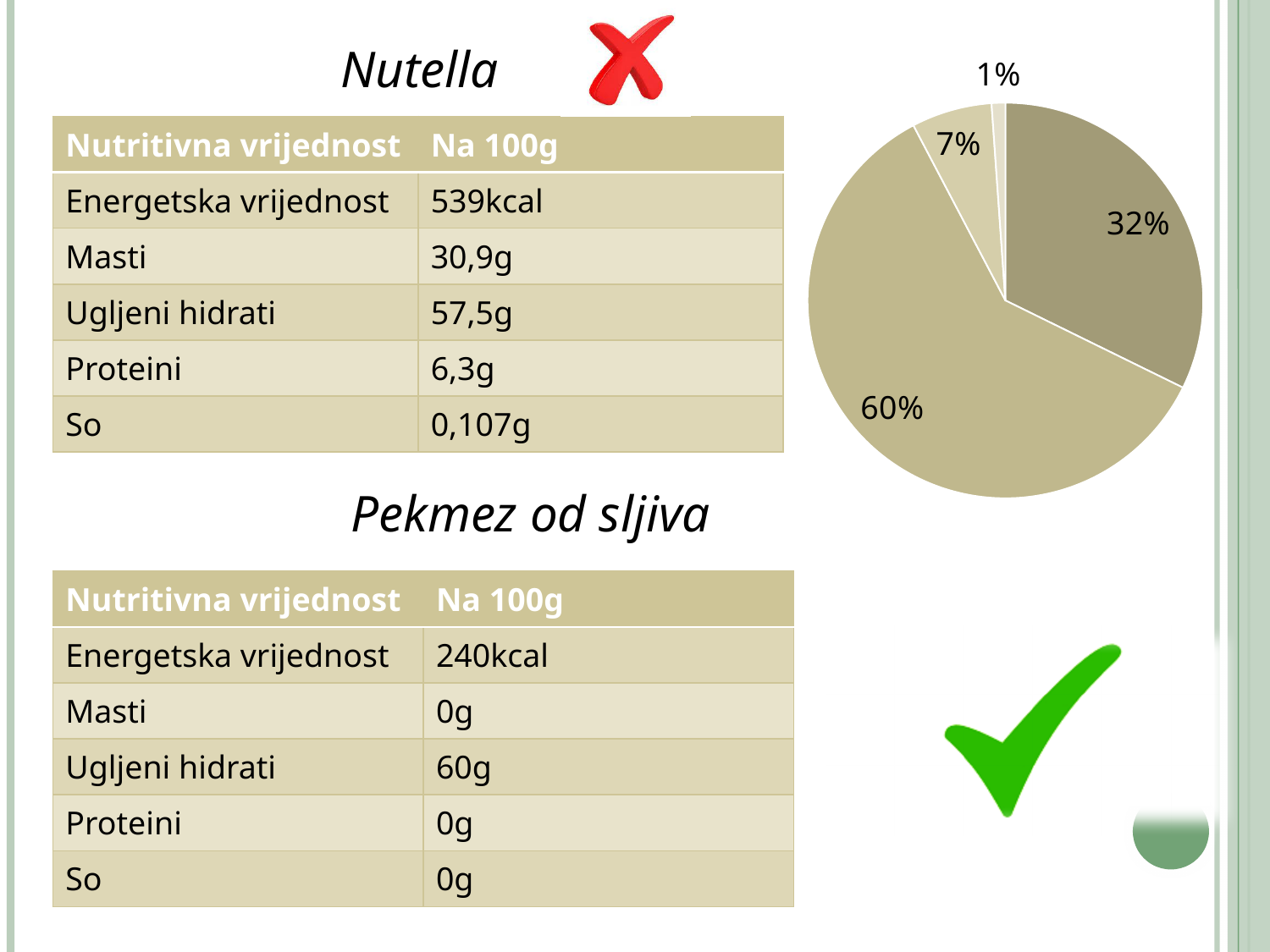
What kind of chart is shown on the right side of the slide? Pie chart Is the largest slice of the pie chart greater or less than 50% of the pie? greater What is the percentage label on the slice of the pie chart located between the 60% slice and the 1% slice? 7% What is the percentage label on the largest slice of the pie chart? 60% Which slice of the pie chart is larger, the one labelled 32% or the one labelled 7%? 32% How many slices does the pie chart have? 4 What is the percentage label on the smallest slice of the pie chart? 1% What is the difference in percentage points between the largest and smallest slices of the pie chart? 59 Does the pie chart display a legend? No What is the difference in percentage points between the 60% slice and the 32% slice of the pie chart? 28 What do the four percentage labels on the pie chart add up to? 100% What is the percentage label on the second-largest slice of the pie chart? 32%